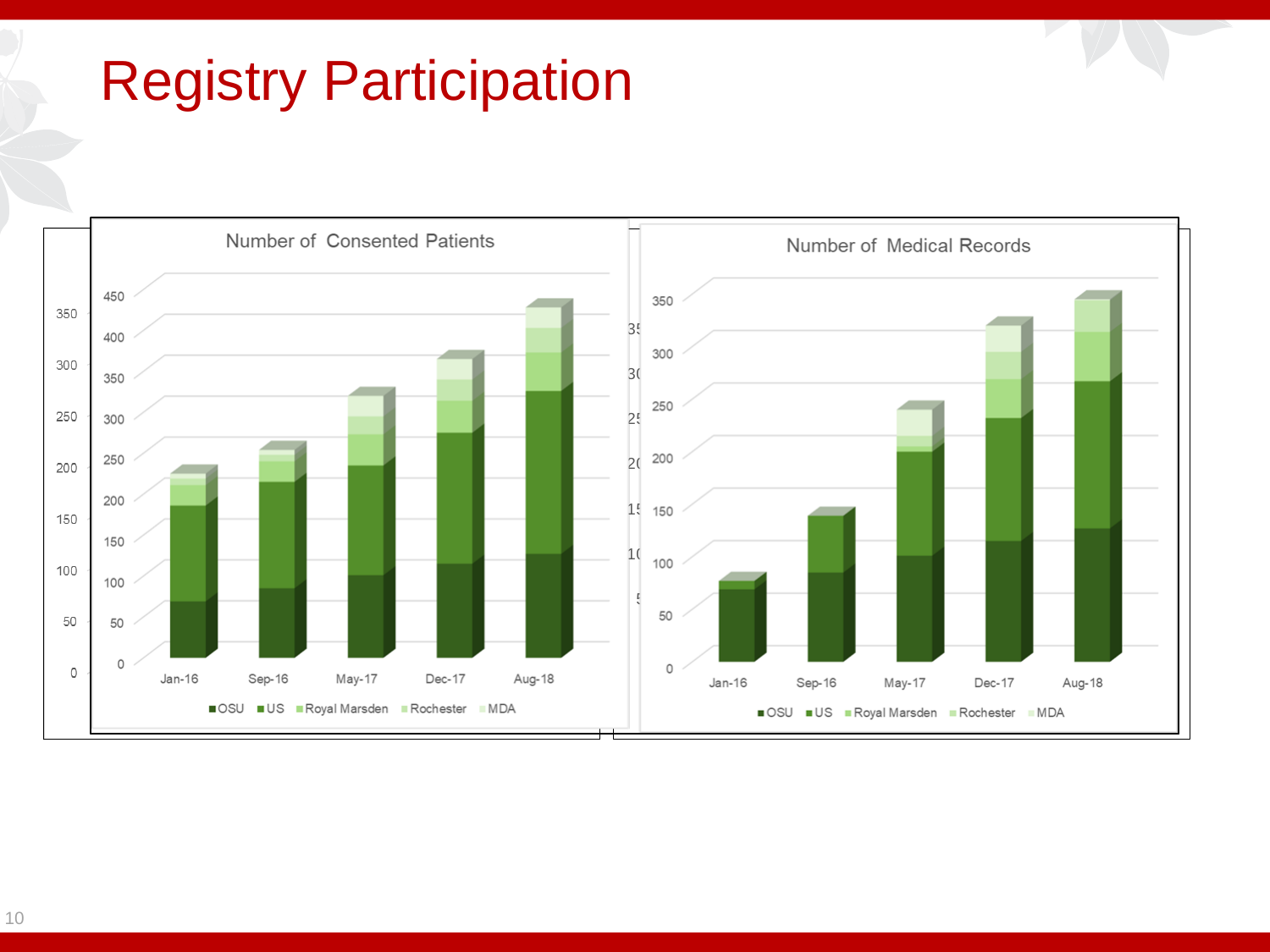
What kind of chart is the "Number of Consented Patients" chart? Stacked bar chart In the "Number of Medical Records" chart, which has the larger total, Sep-16 or May-17? May-17 How many series does the legend of the "Number of Consented Patients" chart list? 5 In the "Number of Medical Records" chart, is the total for Dec-17 greater or less than 300? greater How many time periods are shown on the x axis of the "Number of Medical Records" chart? 5 In the "Number of Consented Patients" chart, is the total for Jan-16 greater or less than 300? less In the "Number of Medical Records" chart, which time period has the shortest stacked bar? Jan-16 In the "Number of Consented Patients" chart, which time period has the tallest stacked bar? Aug-18 In the "Number of Consented Patients" chart, is the total for Aug-18 greater or less than 400? greater Which series is listed first in the legend of the "Number of Medical Records" chart? OSU In the "Number of Consented Patients" chart, do the total bar heights rise or fall from Jan-16 to Aug-18? Rise